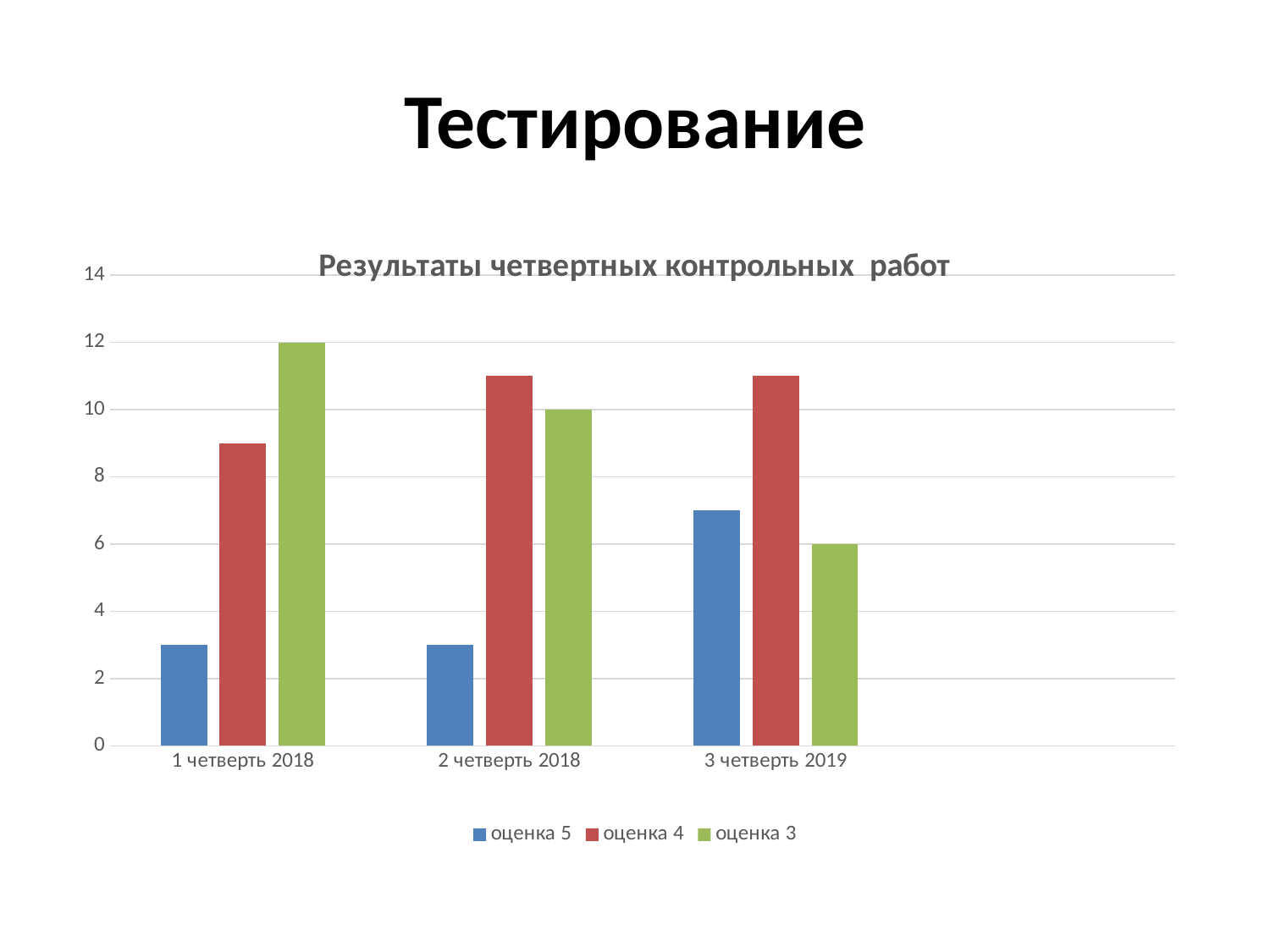
Is the value for оценка 5 in 1 четверть 2018 greater or less than 4? less How many categories are shown on the x axis? 3 What is the value for оценка 3 in 1 четверть 2018? 12 What is the title of the chart? Результаты четвертных контрольных работ What type of chart is shown on the slide? bar chart What is the difference between the оценка 3 values for 1 четверть 2018 and 3 четверть 2019? 6 What is the value for оценка 3 in 2 четверть 2018? 10 Which series has the highest bar in 1 четверть 2018? оценка 3 How many series does the legend list? 3 What is the value for оценка 3 in 3 четверть 2019? 6 Do the values for оценка 3 rise or fall from 1 четверть 2018 to 3 четверть 2019? fall Which series has the lowest bar in 3 четверть 2019? оценка 3